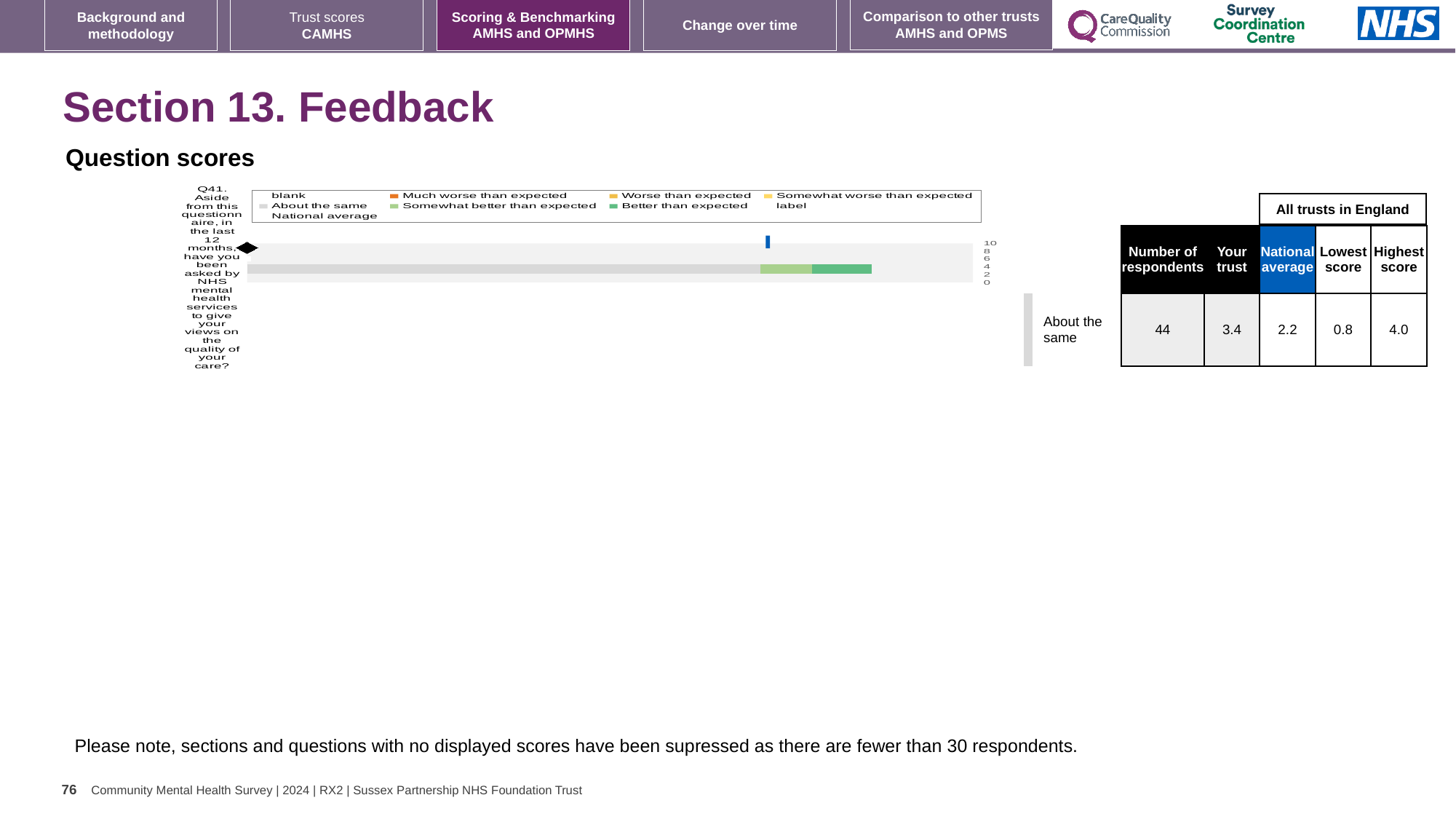
What is the highest tick value shown on the chart's axis? 10 In the table beside the chart, what is the 'Your trust' score for Q41? 3.4 For Q41, what is the difference between the Highest score and the Lowest score in the table beside the chart? 3.2 What kind of chart is shown for Q41 on the slide? bar chart How many entries does the legend of the Q41 chart list? 9 In the table beside the chart, what is the Lowest score among all trusts in England for Q41? 0.8 How many question categories are plotted on the chart? 1 Which legend entry of the chart is shown in orange? Much worse than expected For Q41, which is larger: the 'Your trust' score or the National average? Your trust In the table beside the chart, what is the National average score for Q41? 2.2 In the table beside the chart, what is the Highest score among all trusts in England for Q41? 4.0 In the table beside the chart, how many respondents answered Q41? 44